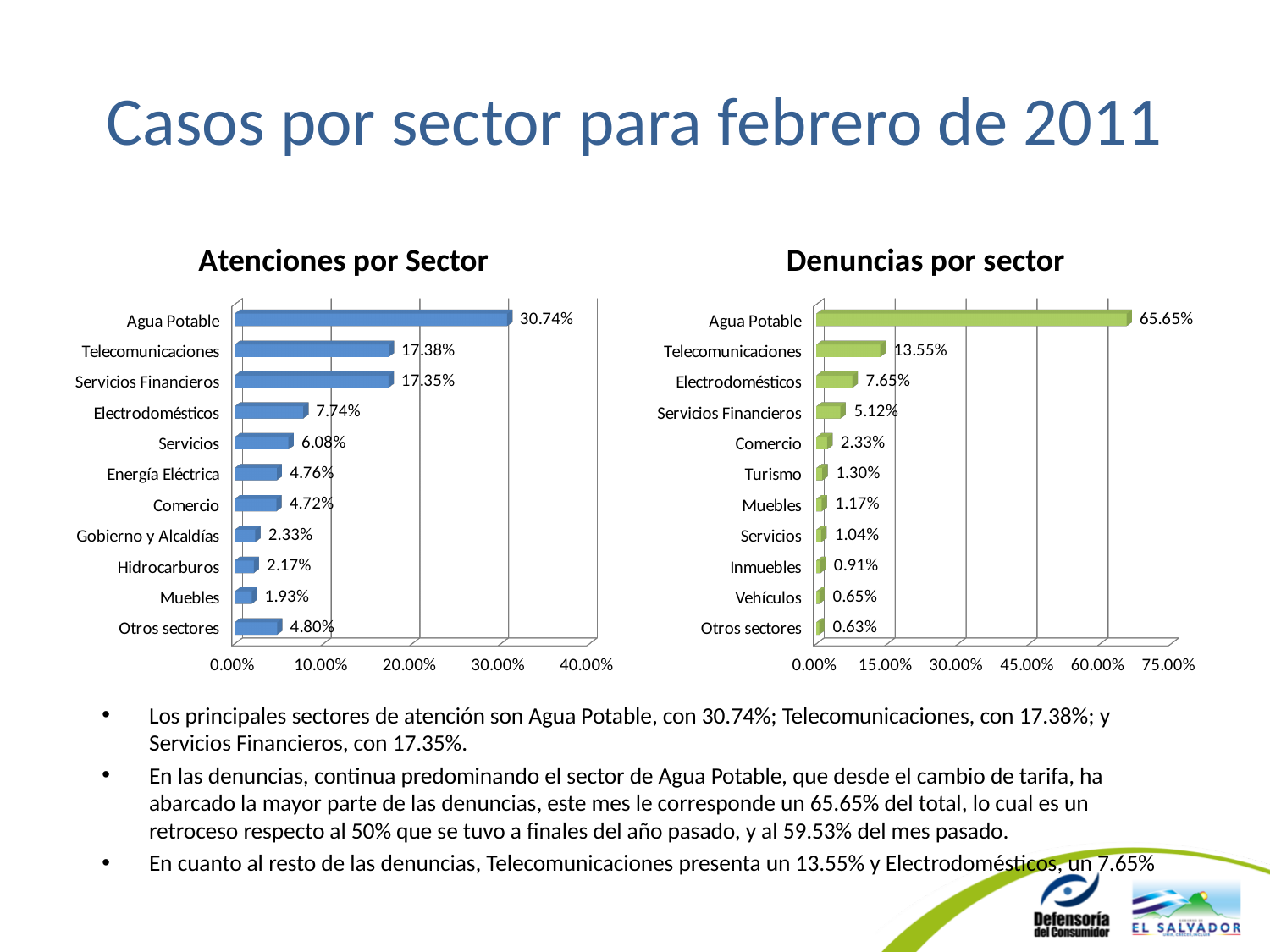
In the 'Atenciones por Sector' chart, which is larger, Servicios or Energía Eléctrica? Servicios In the 'Denuncias por sector' chart, what is the value for Telecomunicaciones? 13.55% In the 'Denuncias por sector' chart, is the value for Agua Potable greater or less than 60.00%? greater In the 'Atenciones por Sector' chart, what is the value for Agua Potable? 30.74% In the 'Atenciones por Sector' chart, which sector has the lowest value? Muebles How many sectors are shown in the 'Atenciones por Sector' chart? 11 In the 'Denuncias por sector' chart, what is the difference between Agua Potable and Telecomunicaciones? 52.10% In the 'Atenciones por Sector' chart, what is the difference between Agua Potable and Telecomunicaciones? 13.36% What type of chart is 'Denuncias por sector'? Bar chart In the 'Atenciones por Sector' chart, what is the value for Hidrocarburos? 2.17% In the 'Denuncias por sector' chart, what is the value for Turismo? 1.30% In the 'Denuncias por sector' chart, which sector has the highest value? Agua Potable